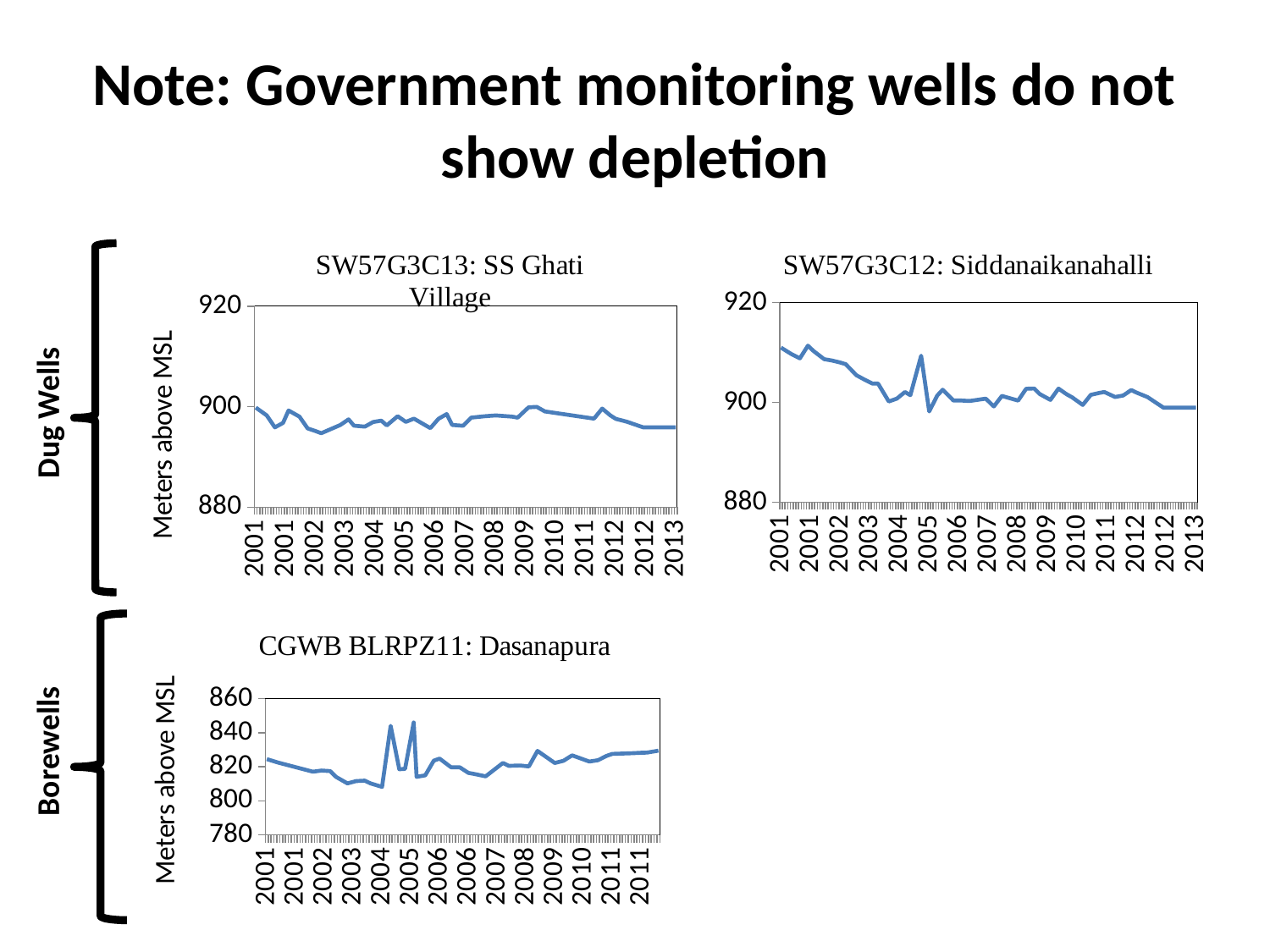
What is the title of the chart at the top right of the slide? SW57G3C12: Siddanaikanahalli In the SW57G3C12: Siddanaikanahalli chart, is the value at the end of the series in 2013 greater or less than 900? less In the SW57G3C12: Siddanaikanahalli chart, is the value at the start of 2001 greater or less than 900? greater In the CGWB BLRPZ11: Dasanapura chart, is the highest peak around 2005 greater or less than 840? greater How many lines are plotted in the CGWB BLRPZ11: Dasanapura chart? 1 What kind of chart is the SW57G3C13: SS Ghati Village chart? line chart What is the y-axis label on the CGWB BLRPZ11: Dasanapura chart? Meters above MSL How many charts are shown on the slide? 3 In the SW57G3C12: Siddanaikanahalli chart, do the values overall rise or fall from 2001 to 2013? fall